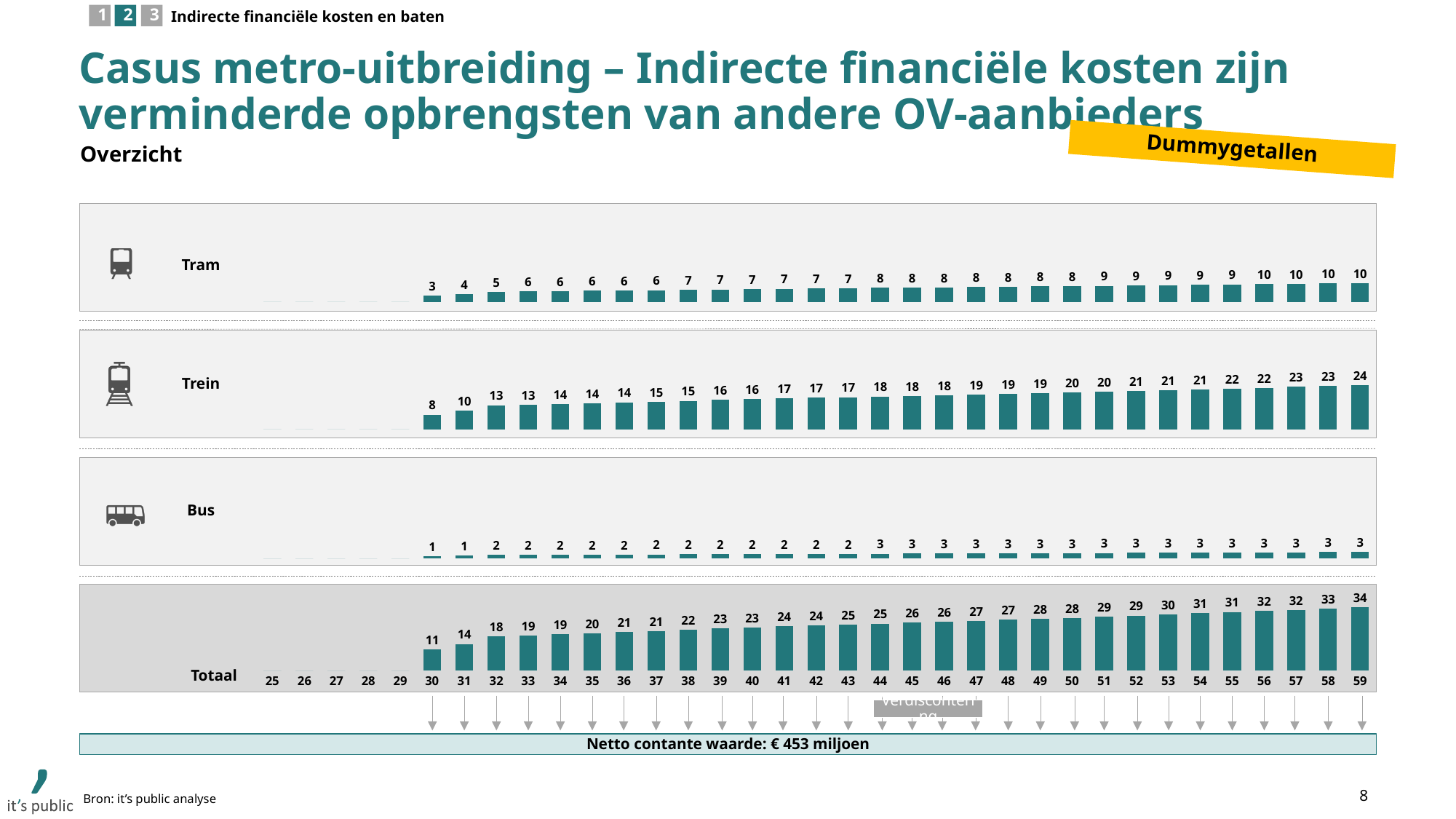
In the Bus chart, what is the value for year 45? 3 In the Trein chart, what is the difference between the value for year 59 and the value for year 30? 16 For year 40, which is larger: the Trein value or the Tram value? Trein What net present value (Netto contante waarde) is stated below the charts? € 453 miljoen In the Totaal chart, do the values rise or fall from year 30 to year 59? rise What kind of chart is used for the Tram, Trein, Bus and Totaal rows? bar chart In the Tram chart, what is the value for year 59? 10 In the Trein chart, which year has the highest value? 59 In the Totaal chart, what is the value for year 59? 34 In the Totaal chart, which year has the lowest value? 30 How many years with plotted bars are shown in the Totaal chart? 30 In the Trein chart, what is the value for year 30? 8